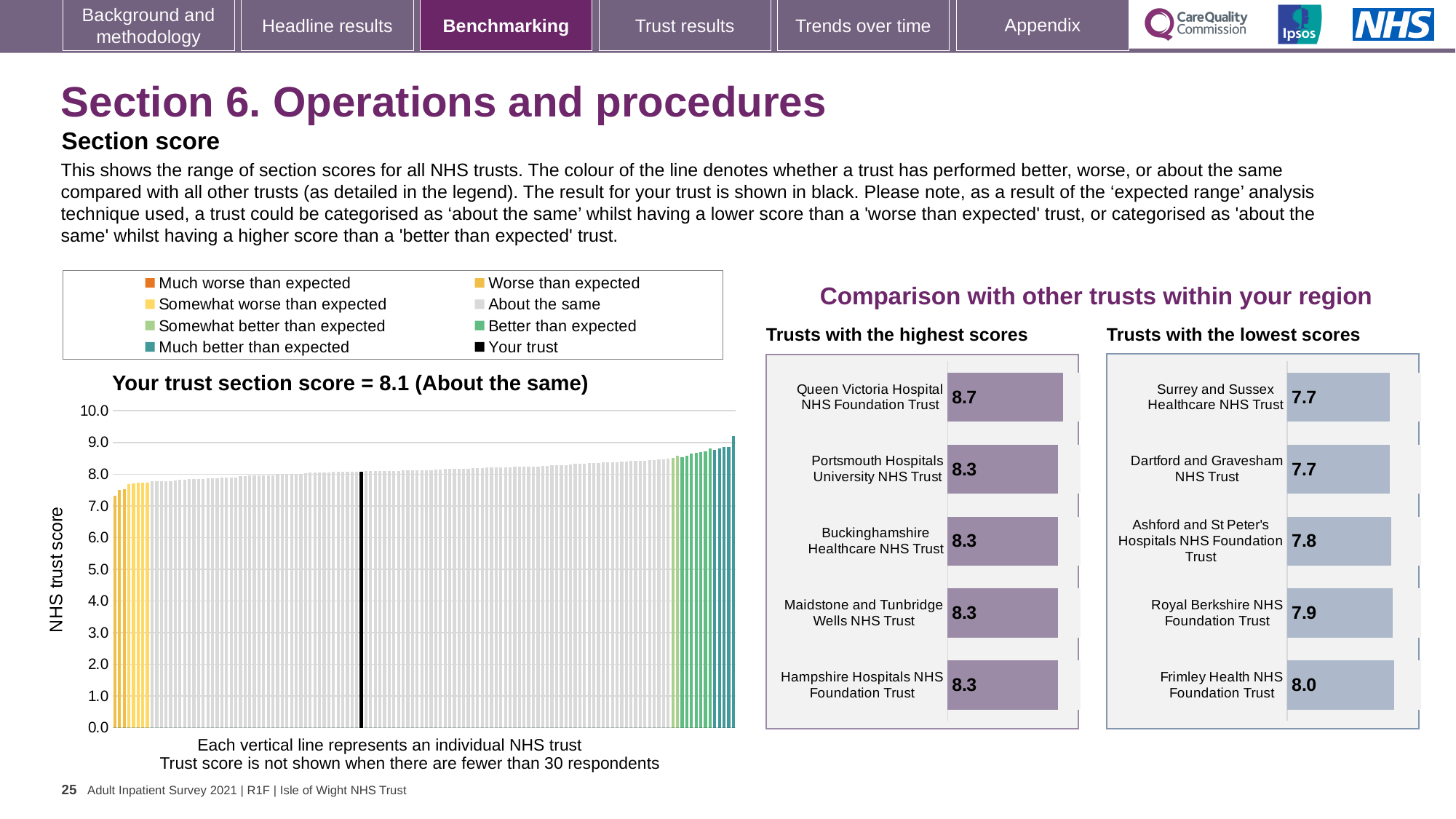
In the 'Your trust section score' chart, is the value of the lowest bar greater or less than 7.0? greater In the 'Your trust section score' chart, what is the section score for your trust? 8.1 How many trusts are shown in the 'Trusts with the lowest scores' chart? 5 In the 'Trusts with the highest scores' chart, what is the score for Queen Victoria Hospital NHS Foundation Trust? 8.7 In the 'Trusts with the lowest scores' chart, what is the score for Frimley Health NHS Foundation Trust? 8.0 In the 'Trusts with the lowest scores' chart, which has the larger score: Royal Berkshire NHS Foundation Trust or Ashford and St Peter's Hospitals NHS Foundation Trust? Royal Berkshire NHS Foundation Trust How many entries does the legend above the 'Your trust section score' chart list? 8 In the 'Your trust section score' chart, do the values rise or fall from left to right along the x axis? rise In the 'Trusts with the highest scores' chart, what is the difference between the scores of Queen Victoria Hospital NHS Foundation Trust and Portsmouth Hospitals University NHS Trust? 0.4 In the 'Trusts with the highest scores' chart, which trust has the highest score? Queen Victoria Hospital NHS Foundation Trust What kind of chart is the 'Your trust section score' chart? bar chart What is the y-axis label of the 'Your trust section score' chart? NHS trust score